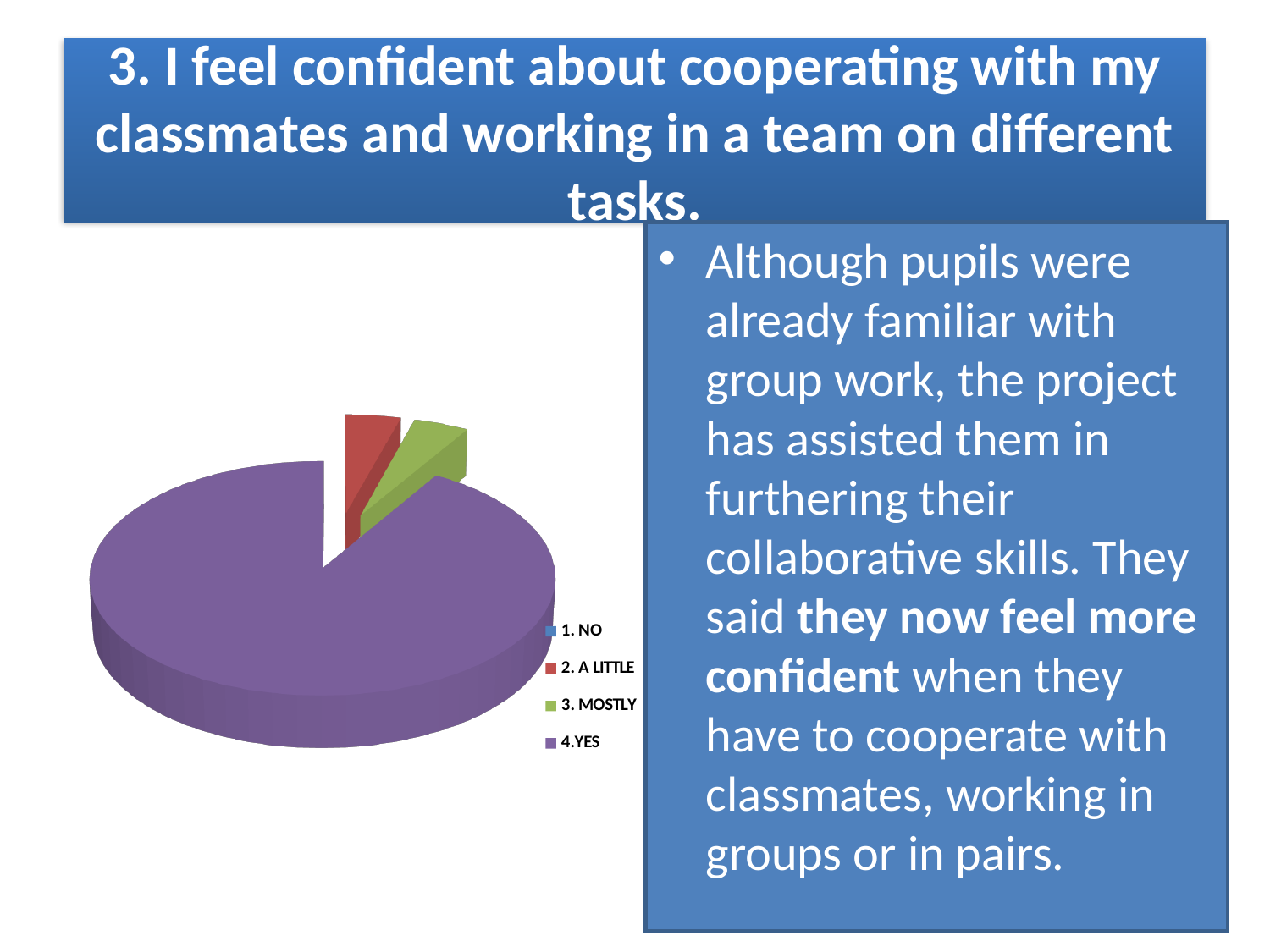
How many entries does the legend of the pie chart list? 4 Which is larger in the pie chart, the slice for 4.YES or the slice for 2. A LITTLE? 4.YES Which category has the largest slice in the pie chart? 4.YES Which is larger in the pie chart, the slice for 4.YES or the slice for 3. MOSTLY? 4.YES Does the slice for 4.YES take up more or less than half of the pie chart? more Which legend entry in the pie chart is shown in green? 3. MOSTLY What colour is the slice for 4.YES in the pie chart? purple What kind of chart is shown on the slide? pie chart